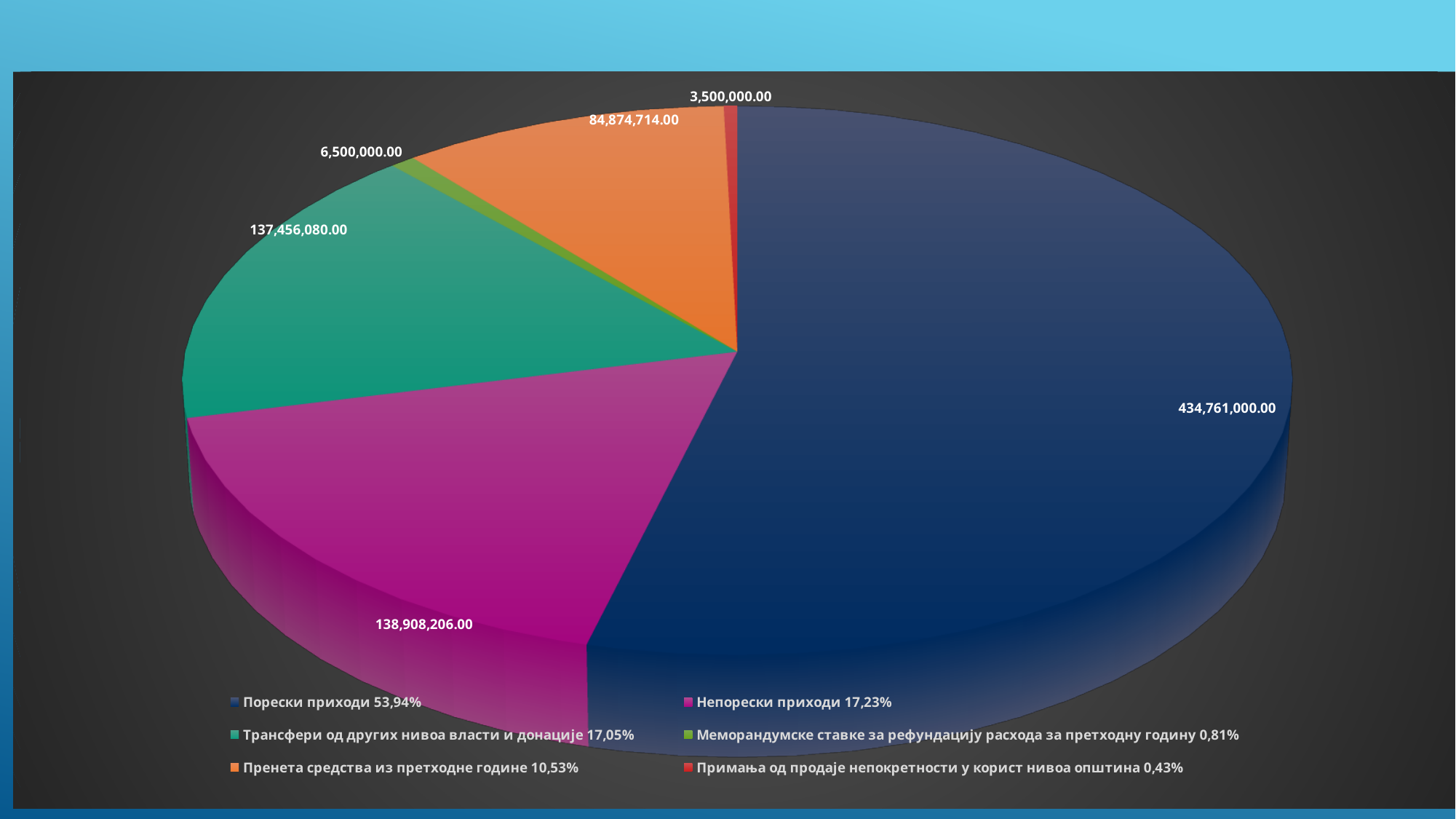
What kind of chart is shown on the slide? Pie chart What is the difference between the values for Непорески приходи and Трансфери од других нивоа власти и донације? 1,452,126.00 What is the value for Меморандумске ставке за рефундацију расхода за претходну годину? 6,500,000.00 What share of the pie does Пренета средства из претходне године represent, according to the legend? 10,53% Which is larger, the value for Непорески приходи or the value for Трансфери од других нивоа власти и донације? Непорески приходи What colour is the slice for Непорески приходи? Magenta What is the difference between the values for Меморандумске ставке за рефундацију расхода за претходну годину and Примања од продаје непокретности у корист нивоа општина? 3,000,000.00 What is the value for Пренета средства из претходне године? 84,874,714.00 Which category has the smallest slice of the pie? Примања од продаје непокретности у корист нивоа општина What is the value for Порески приходи? 434,761,000.00 How many slices does the pie chart have? 6 Which category has the largest slice of the pie? Порески приходи